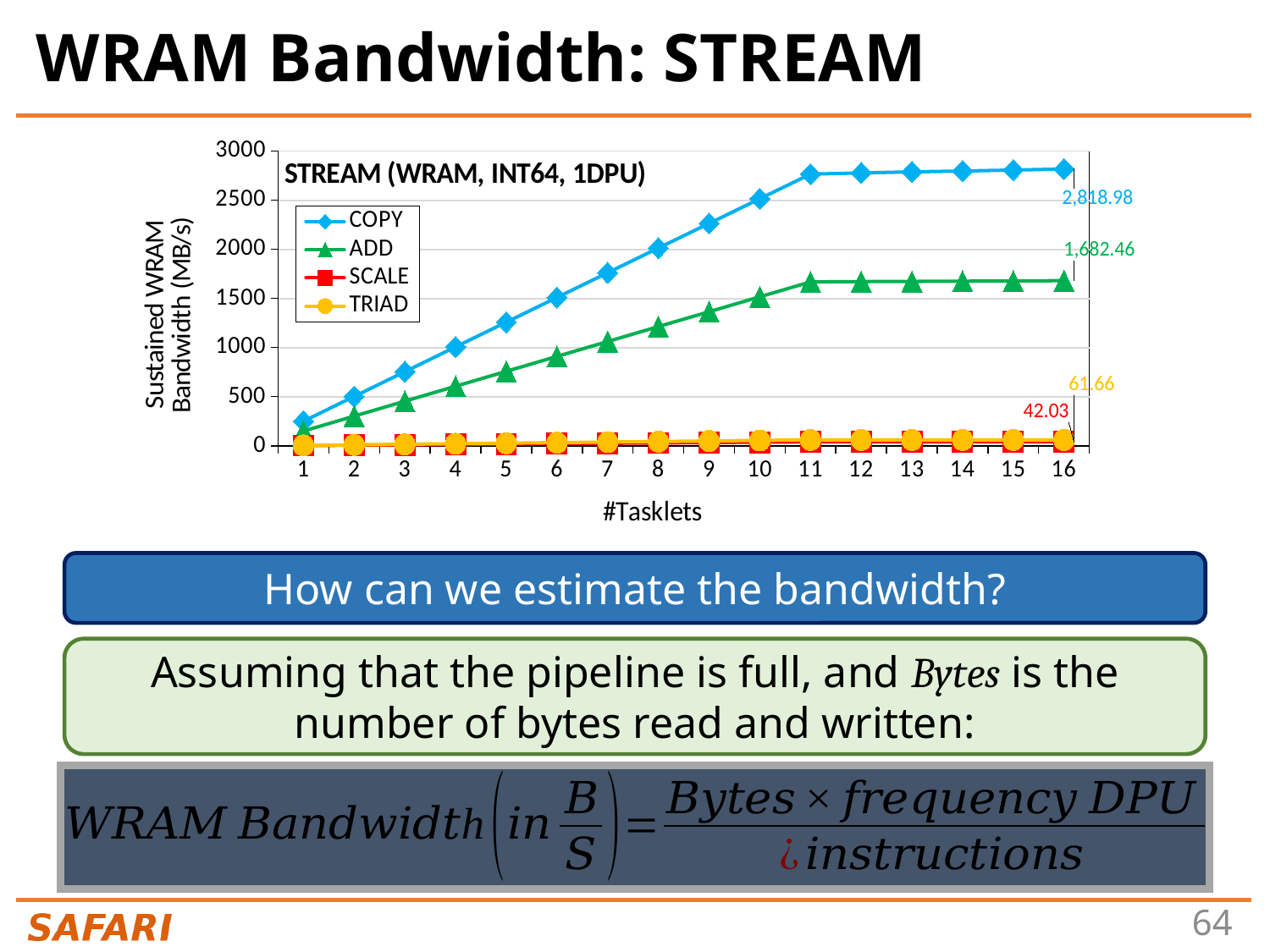
Which series has the lowest sustained WRAM bandwidth at 16 tasklets? SCALE What kind of chart is shown on the slide? Line chart Is the value for COPY at 8 tasklets greater or less than 1500? greater What is the difference between the COPY and ADD values at 16 tasklets? 1,136.52 What is the value of COPY at 16 tasklets? 2,818.98 How many series does the legend list? 4 At 16 tasklets, which is larger: TRIAD or SCALE? TRIAD What is the value of SCALE at 16 tasklets? 42.03 What is the value of ADD at 16 tasklets? 1,682.46 What is the value of TRIAD at 16 tasklets? 61.66 Which series has the highest sustained WRAM bandwidth at 16 tasklets? COPY What is the label of the x axis? #Tasklets